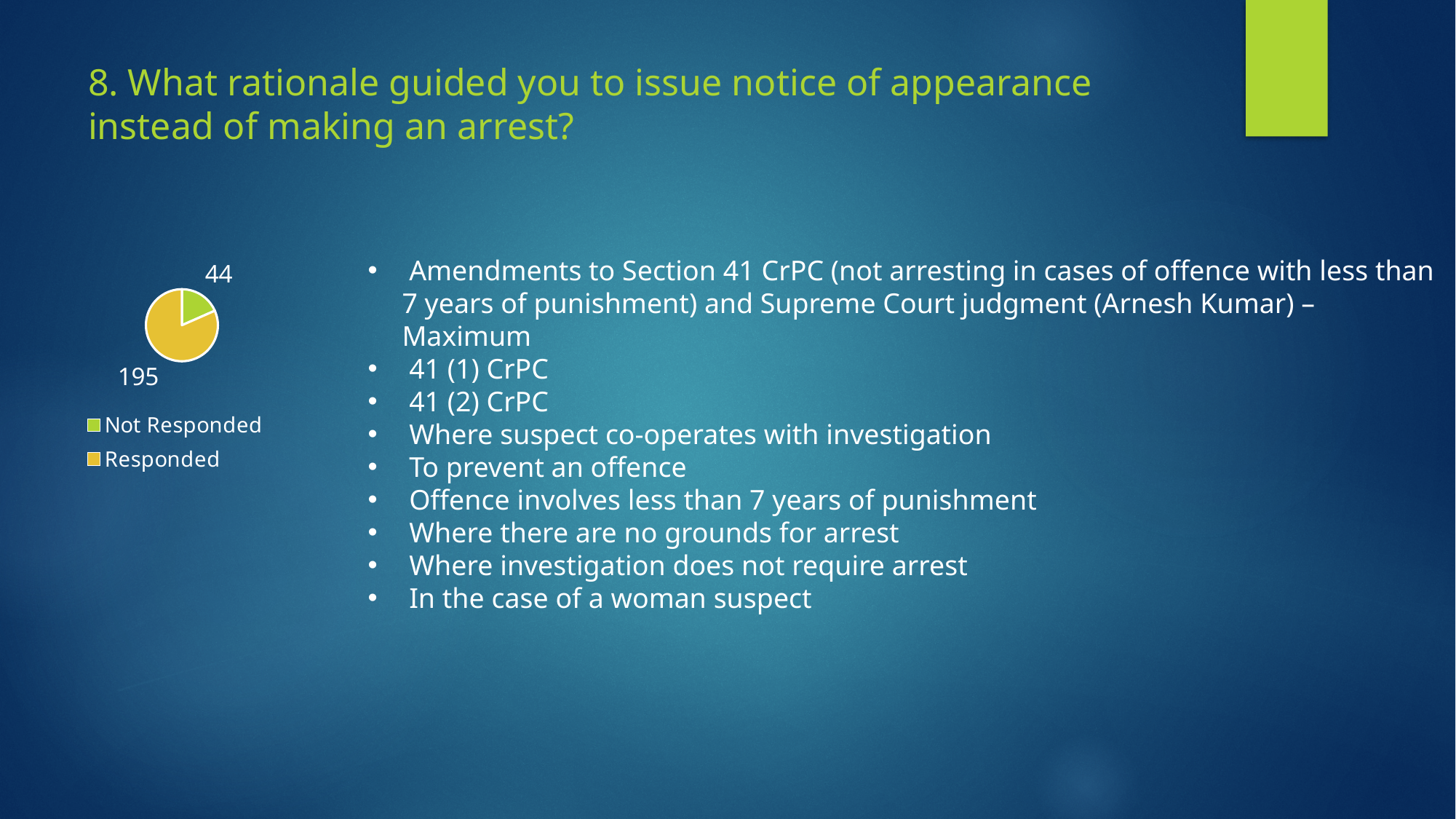
How many slices does the pie chart have? 2 What value is shown for Responded in the pie chart? 195 What is the difference between the Responded and Not Responded values in the pie chart? 151 Which slice of the pie chart is the largest? Responded Which colour represents Responded in the pie chart? Yellow Which is larger in the pie chart, Responded or Not Responded? Responded What value is shown for Not Responded in the pie chart? 44 How many entries does the pie chart legend list? 2 Which colour represents Not Responded in the pie chart? Green What is the total of the two values shown in the pie chart? 239 Which slice of the pie chart is the smallest? Not Responded What kind of chart is shown on the slide? Pie chart